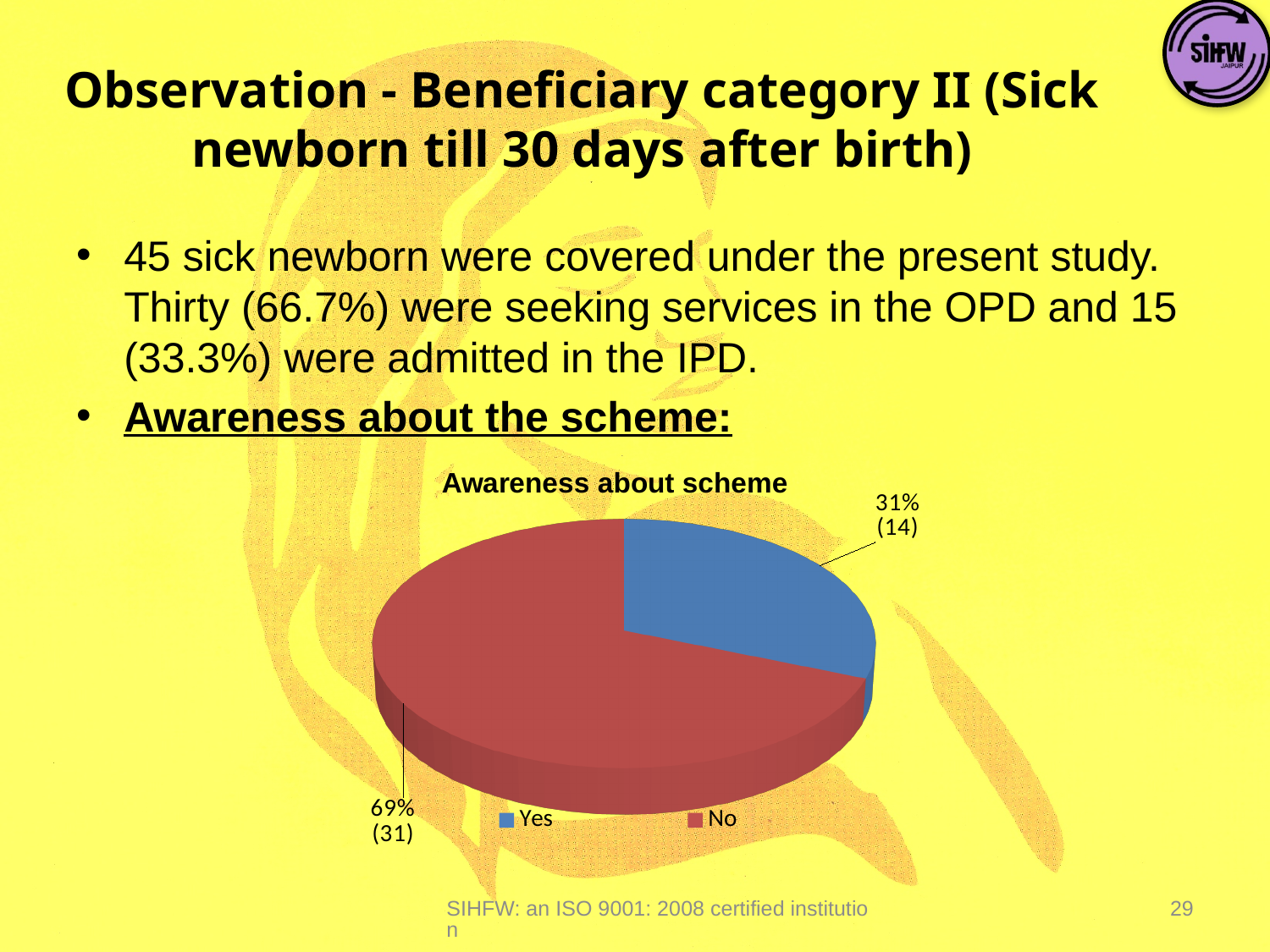
Which slice is the largest in the pie chart? No Which slice is the smallest in the pie chart? Yes What type of chart is shown on the slide? pie chart What is the title of the chart? Awareness about scheme What colour is the 'Yes' slice in the pie chart? blue What percentage of the pie does the 'Yes' slice represent? 31% How many respondents are in the 'No' slice? 31 What percentage of the pie does the 'No' slice represent? 69% Which is larger, the 'Yes' slice or the 'No' slice? No What is the difference in count between the 'No' and 'Yes' slices? 17 How many categories does the legend list? 2 How many respondents are in the 'Yes' slice? 14